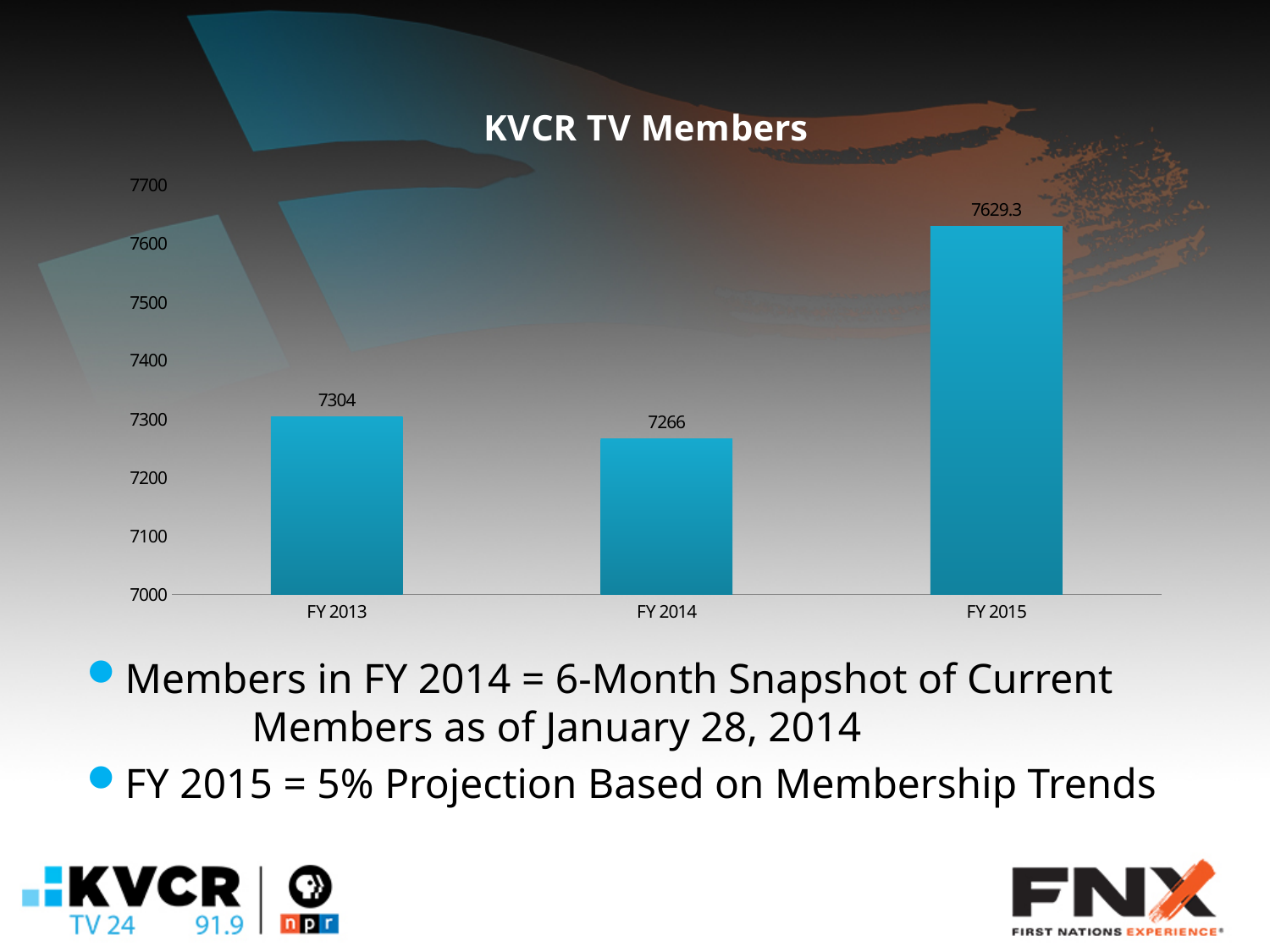
What kind of chart is shown on the slide? Bar chart What is the value for FY 2015? 7629.3 What is the value for FY 2013? 7304 What is the difference between the FY 2013 and FY 2014 values? 38 What is the title of the chart? KVCR TV Members Which fiscal year has the highest number of members? FY 2015 Is the value for FY 2015 greater or less than 7600? greater What is the difference between the FY 2015 and FY 2014 values? 363.3 How many fiscal years are shown in the chart? 3 Which fiscal year has the lowest number of members? FY 2014 What is the value for FY 2014? 7266 Which is larger, the value for FY 2013 or FY 2014? FY 2013